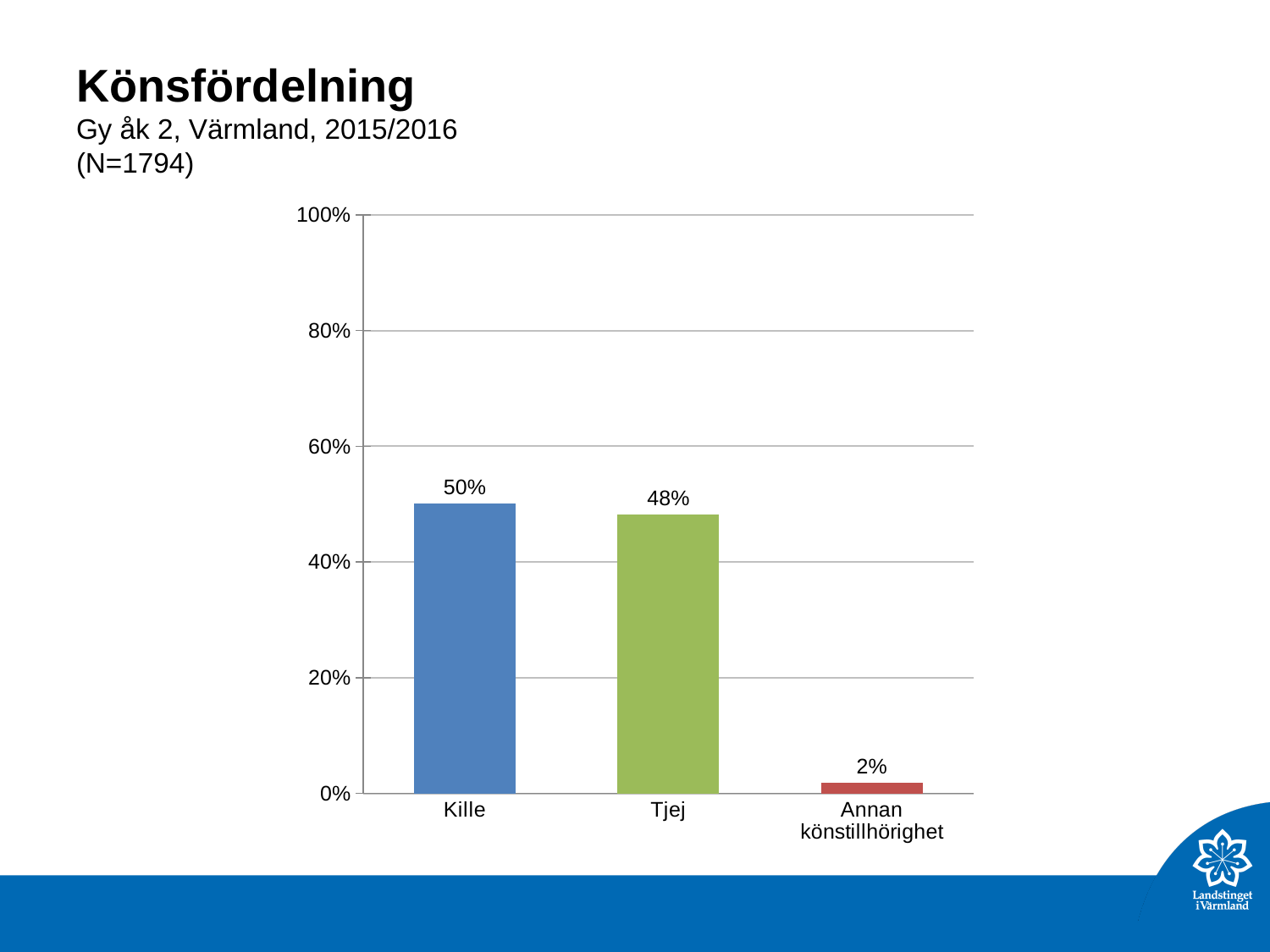
What is the value for Annan könstillhörighet? 2% What is the title of the slide? Könsfördelning What is the difference between the values for Tjej and Annan könstillhörighet? 46% What is the value for Kille? 50% What kind of chart is shown on the slide? bar chart Which category has the highest value? Kille How many categories are shown on the x axis? 3 Which is larger, the value for Tjej or the value for Annan könstillhörighet? Tjej Which category has the lowest value? Annan könstillhörighet Is the value for Kille greater or less than 40%? greater What is the value for Tjej? 48% What is the difference between the values for Kille and Tjej? 2%